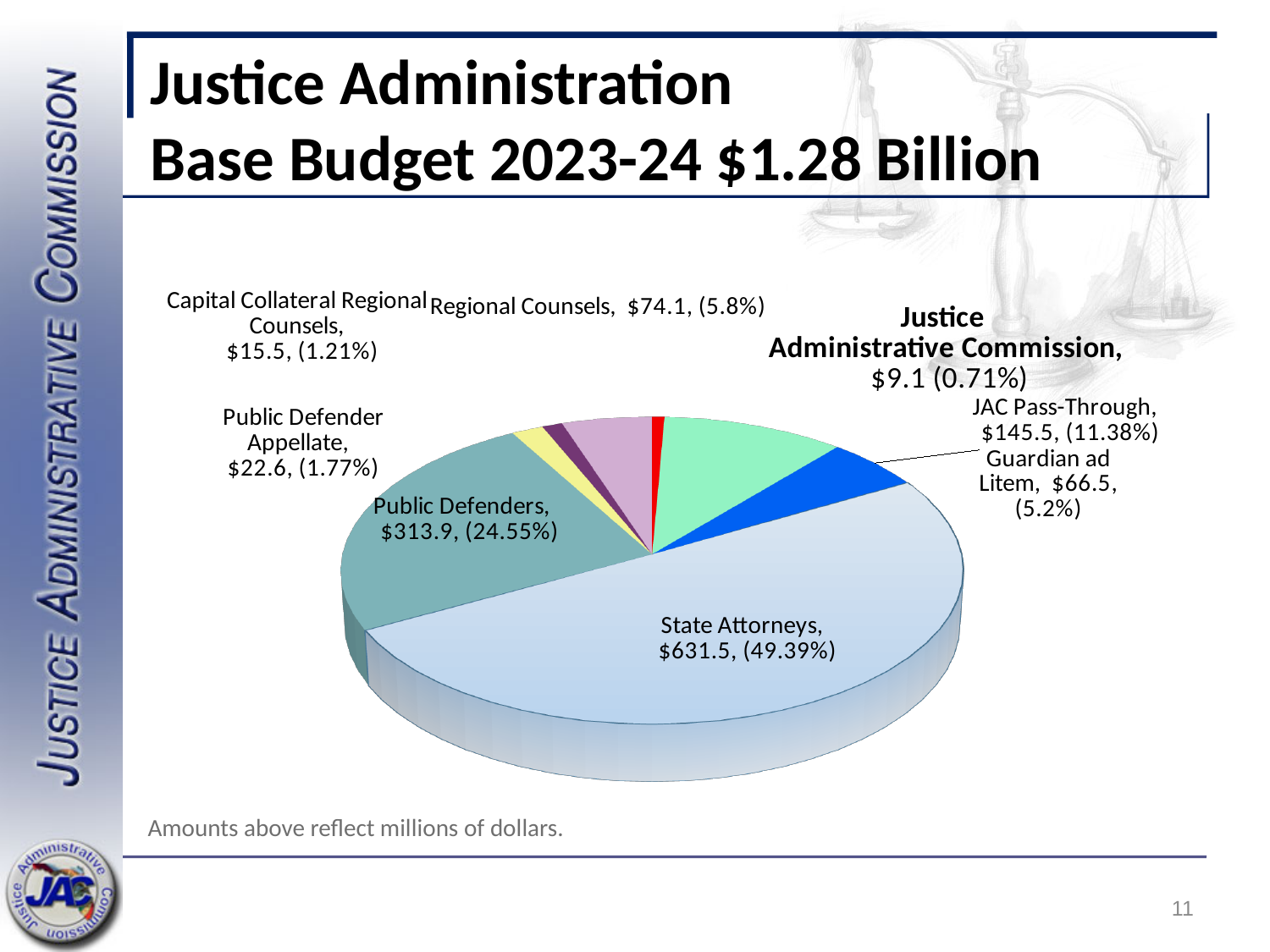
What share of the pie does Guardian ad Litem represent? 5.2% What is the difference in value between State Attorneys and Public Defenders? $317.6 What is the value for State Attorneys? $631.5 Which category has the smallest slice of the pie? Justice Administrative Commission According to the note below the chart, what unit are the amounts in? Millions of dollars Which category has the largest slice of the pie? State Attorneys How many slices does the pie chart have? 8 What is the value for JAC Pass-Through? $145.5 Which is larger, Regional Counsels or Guardian ad Litem? Regional Counsels What share of the pie do Public Defenders represent? 24.55% What is the value for Public Defender Appellate? $22.6 What kind of chart is shown on the slide? Pie chart